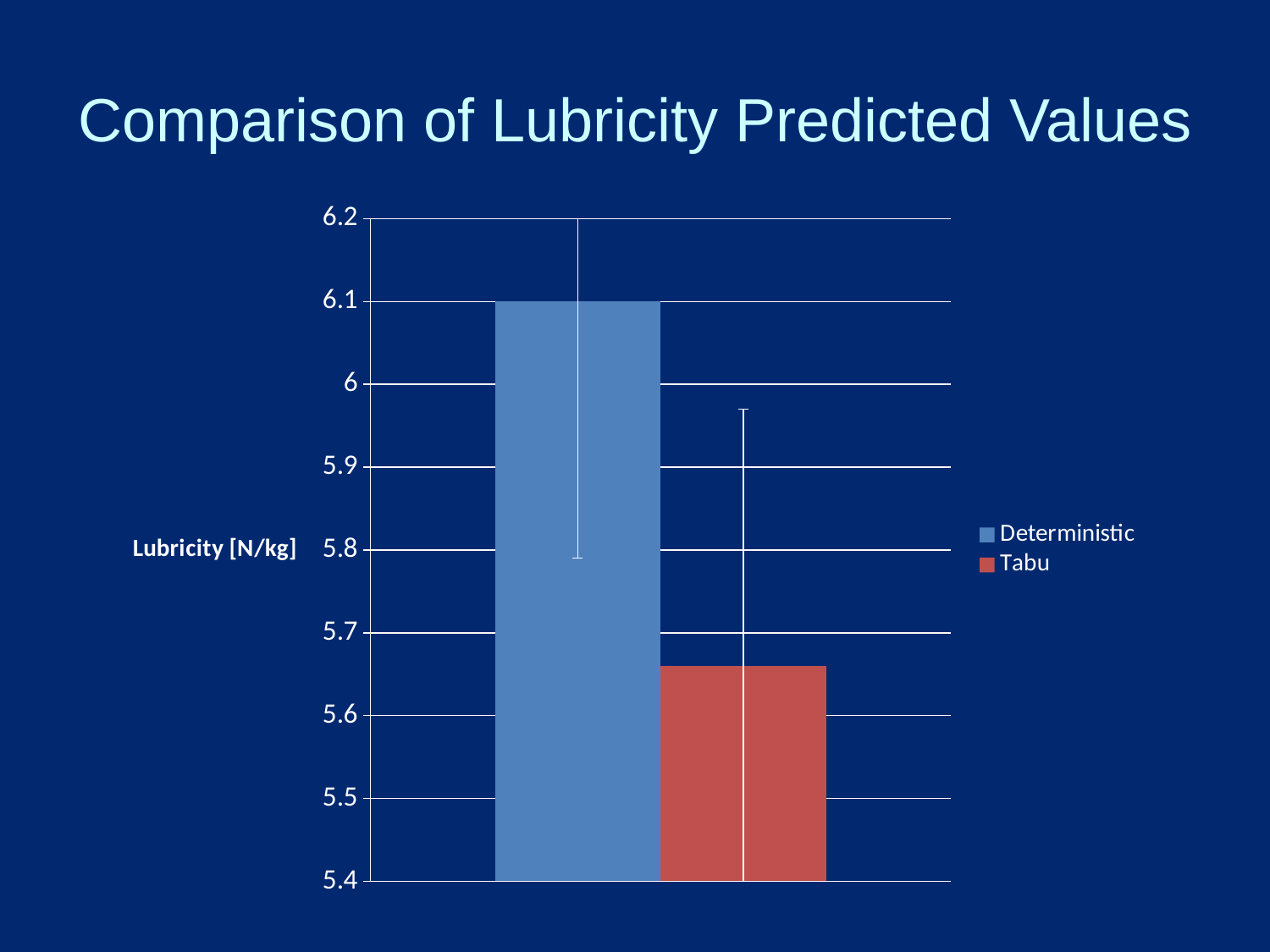
Which series has the highest predicted lubricity value? Deterministic What is the predicted lubricity value for the Deterministic series? 6.1 What is the title of the slide? Comparison of Lubricity Predicted Values How many series does the legend list? 2 Is the value for Deterministic greater or less than 6? greater Is the value for Tabu greater or less than 5.6? greater Which series has the lowest predicted lubricity value? Tabu What kind of chart is shown on the slide? bar chart Which series has the higher predicted lubricity value? Deterministic How many bars are plotted in the chart? 2 What is the label on the vertical axis? Lubricity [N/kg] Is the value for Tabu greater or less than 5.7? less